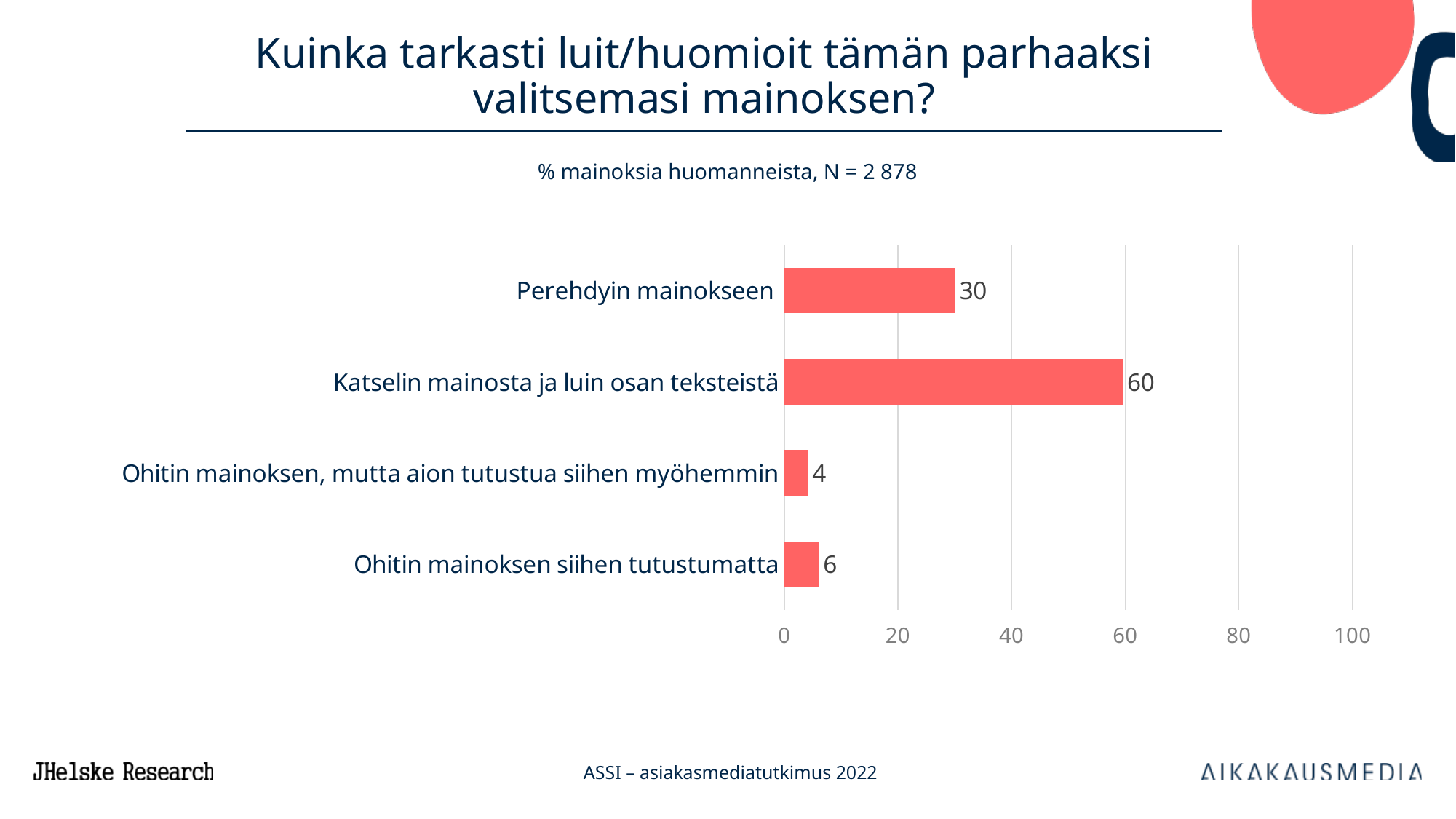
Which category has the lowest value? Ohitin mainoksen, mutta aion tutustua siihen myöhemmin What is the difference between the values for "Katselin mainosta ja luin osan teksteistä" and "Perehdyin mainokseen"? 30 How many categories are shown in the chart? 4 What kind of chart is shown on the slide? Bar chart Is the value for "Perehdyin mainokseen" greater or less than 40? less What is the value for "Perehdyin mainokseen"? 30 Which is larger: the value for "Ohitin mainoksen siihen tutustumatta" or "Ohitin mainoksen, mutta aion tutustua siihen myöhemmin"? Ohitin mainoksen siihen tutustumatta What is the sample size (N) stated in the chart subtitle? 2 878 What is the value for "Katselin mainosta ja luin osan teksteistä"? 60 What is the value for "Ohitin mainoksen siihen tutustumatta"? 6 What is the value for "Ohitin mainoksen, mutta aion tutustua siihen myöhemmin"? 4 Which category has the highest value? Katselin mainosta ja luin osan teksteistä